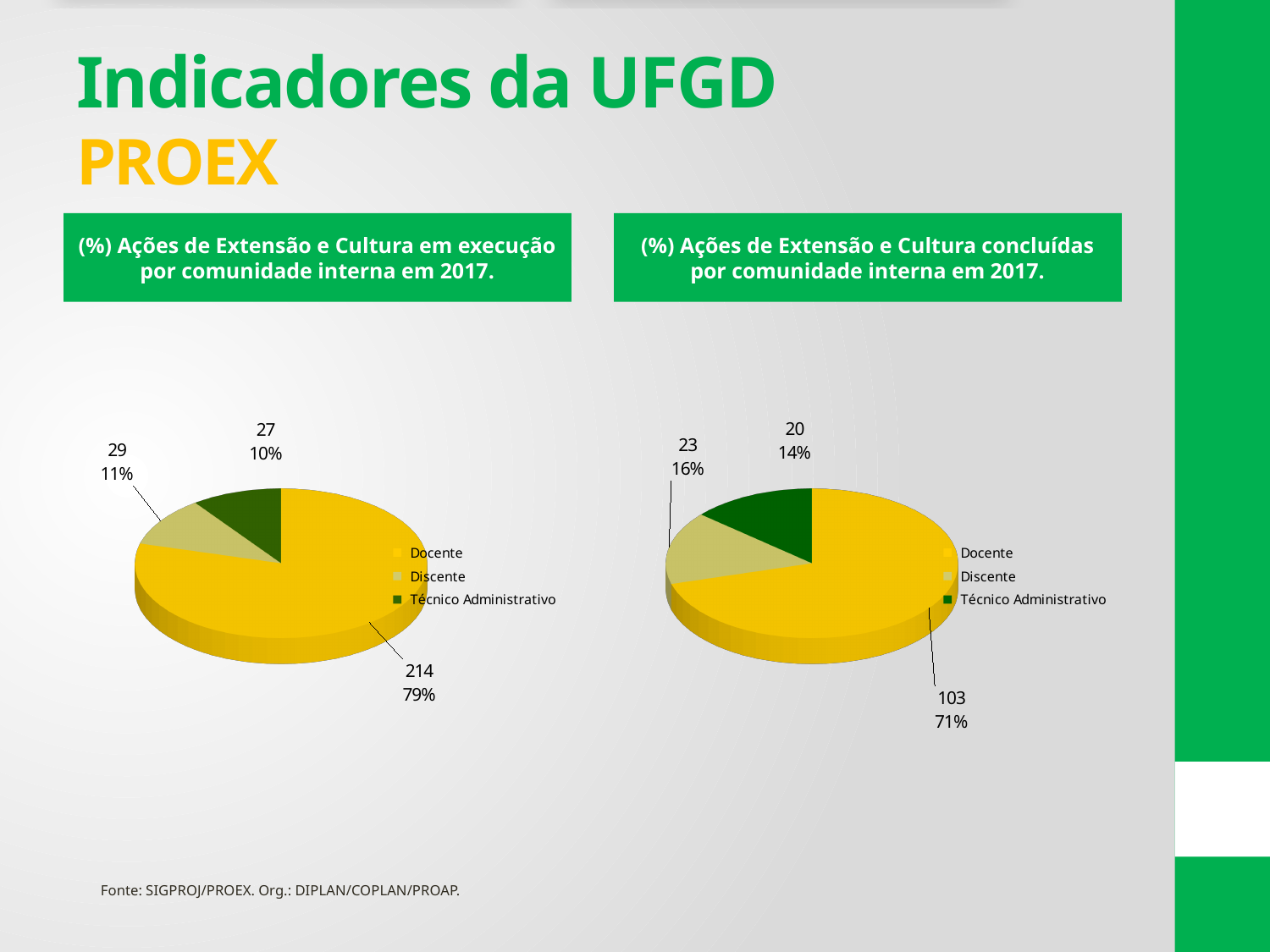
In the right chart (ações concluídas), what is the count for Discente? 23 In the left chart (ações em execução), which category has the largest slice? Docente In the left chart (ações em execução), what is the difference between the Docente count and the Discente count? 185 In the left chart (ações em execução), what is the count for Técnico Administrativo? 27 In the right chart (ações concluídas), which category has the smallest slice? Técnico Administrativo What type of chart is used on this slide? Pie chart In the left chart (ações em execução), what is the count for Docente? 214 In the right chart (ações concluídas), what is the count for Docente? 103 How many categories does the legend of the right chart (ações concluídas) list? 3 In the left chart (ações em execução), what percentage share does Discente have? 11% In the right chart (ações concluídas), what percentage share does Técnico Administrativo have? 14% In the right chart (ações concluídas), which is larger, the Discente count or the Técnico Administrativo count? Discente